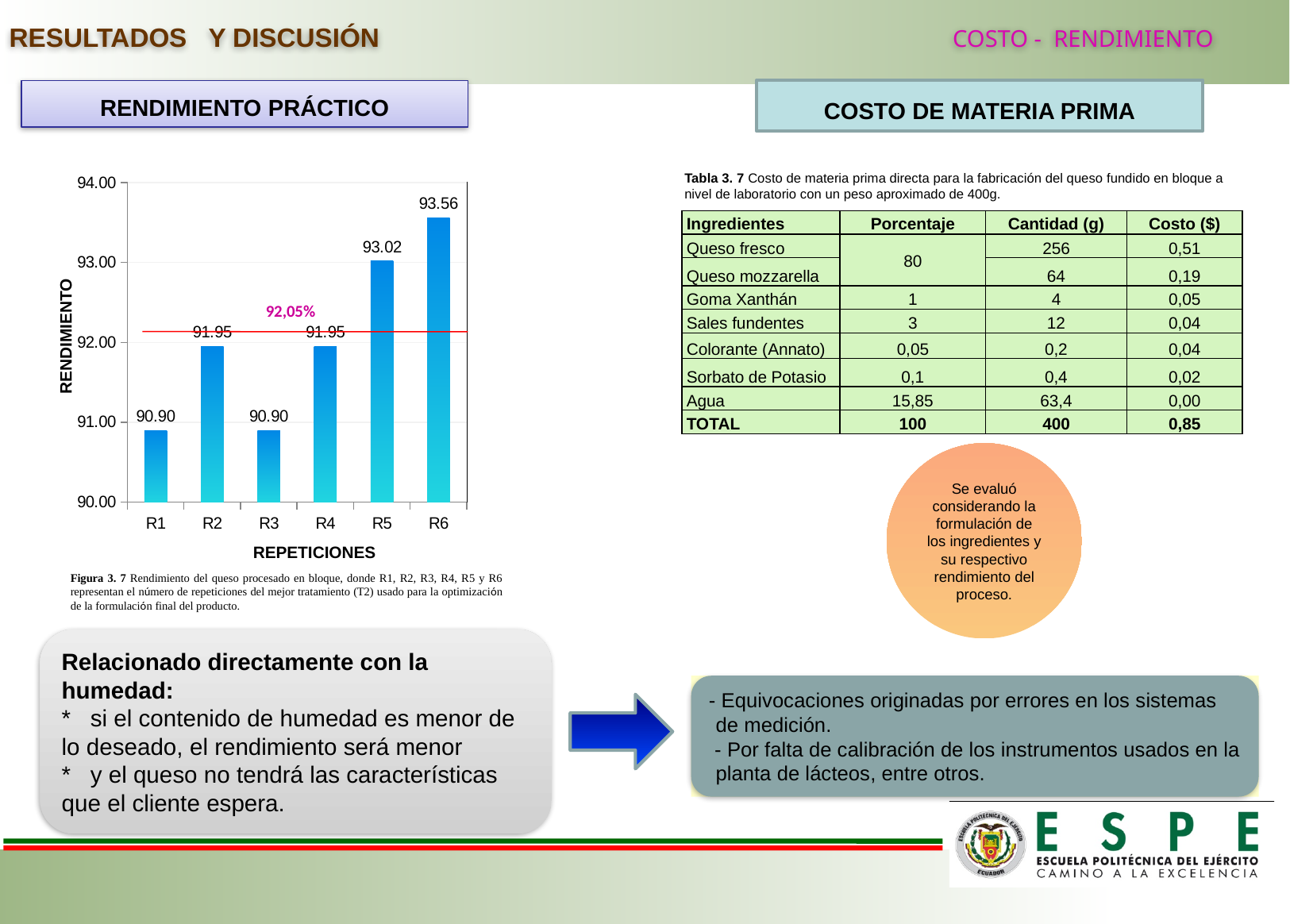
What is the value for R5 in the bar chart? 93.02 What kind of chart is shown on the slide? bar chart What is the value for R1 in the bar chart? 90.90 Is the value for R3 in the bar chart greater or less than 91.00? less How many repetitions are shown on the x axis of the bar chart? 6 What is the label of the y axis of the bar chart? RENDIMIENTO What is the value marked by the red horizontal line in the bar chart? 92,05% Which repetition has the highest value in the bar chart? R6 Which is larger in the bar chart, the value for R4 or the value for R5? R5 What is the value for R6 in the bar chart? 93.56 What is the difference between the values for R6 and R5 in the bar chart? 0.54 What is the difference between the values for R2 and R1 in the bar chart? 1.05